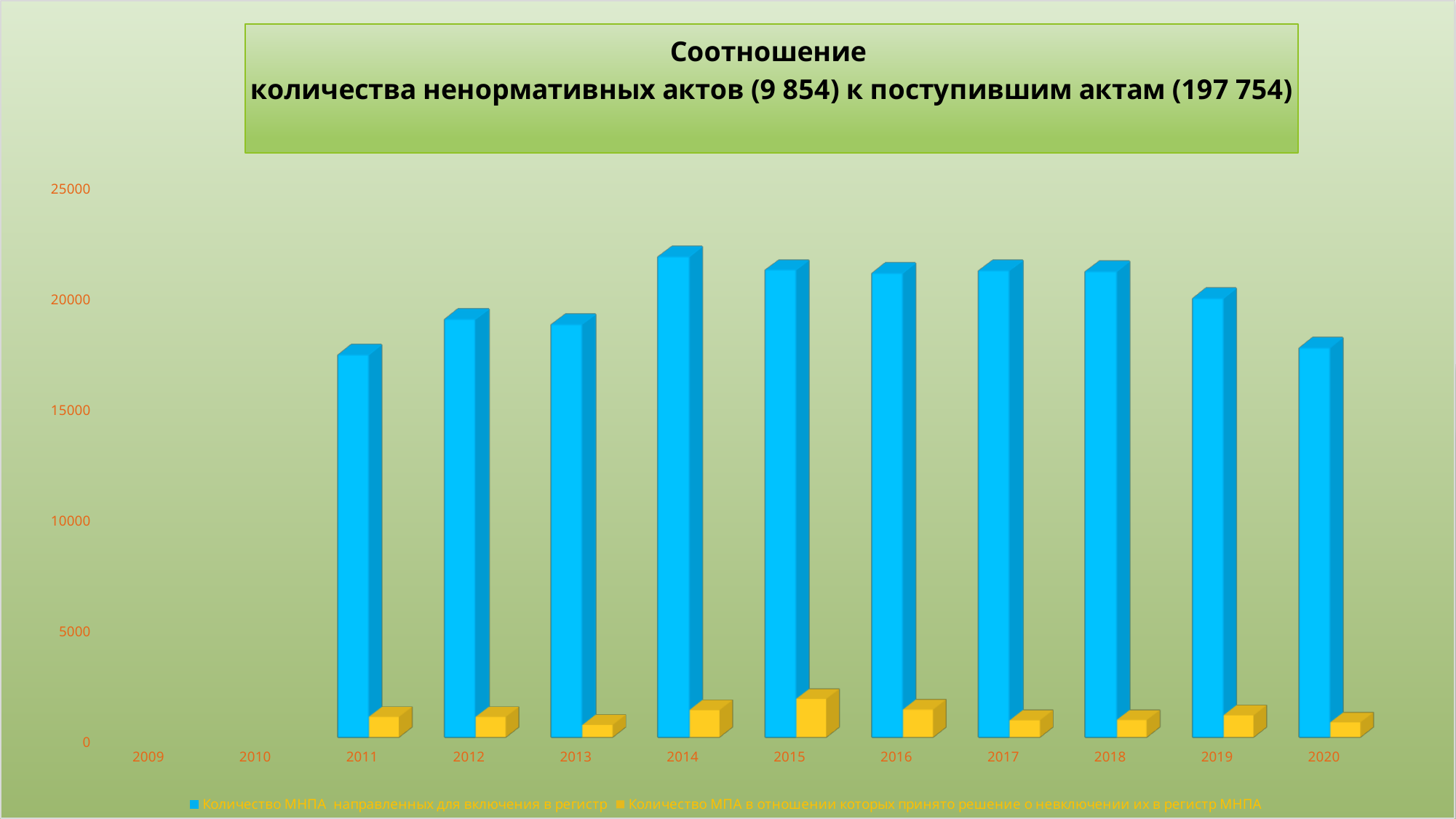
Which year has the larger blue bar, 2014 or 2019? 2014 In which year is the blue bar (Количество МНПА направленных для включения в регистр) the highest? 2014 How many years are labelled on the x axis? 12 Is the value of the yellow bar for 2015 greater or less than 5000? less In which year is the yellow bar (Количество МПА в отношении которых принято решение о невключении их в регистр МНПА) the highest? 2015 Which years on the x axis have no bars plotted? 2009 and 2010 Is the value of the blue bar for 2020 greater or less than 20000? less Is the value of the blue bar for 2014 greater or less than 20000? greater What colour represents the series 'Количество МНПА направленных для включения в регистр'? blue What kind of chart is shown on the slide? bar chart How many series does the legend list? 2